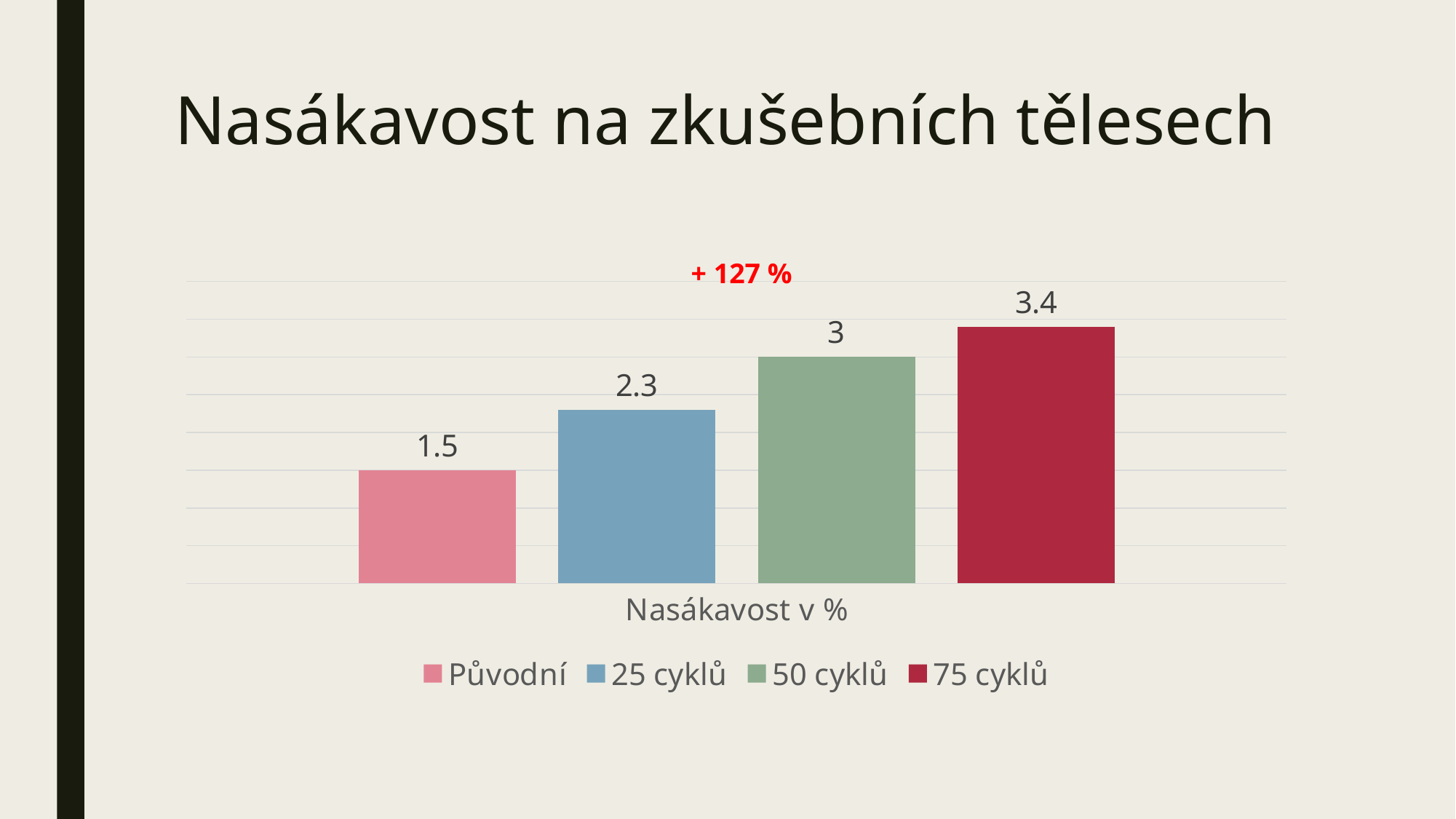
How many series does the legend list? 4 Which is larger, the value for 25 cyklů or the value for 50 cyklů? 50 cyklů What is the value for 25 cyklů? 2.3 What is the value for 75 cyklů? 3.4 Which series has the highest value? 75 cyklů What kind of chart is shown on the slide? bar chart What is the difference between the values for 75 cyklů and Původní? 1.9 What is the value for Původní? 1.5 What is the difference between the values for 50 cyklů and 25 cyklů? 0.7 What is the value for 50 cyklů? 3 Which series has the lowest value? Původní Do the values rise or fall from Původní to 75 cyklů? rise